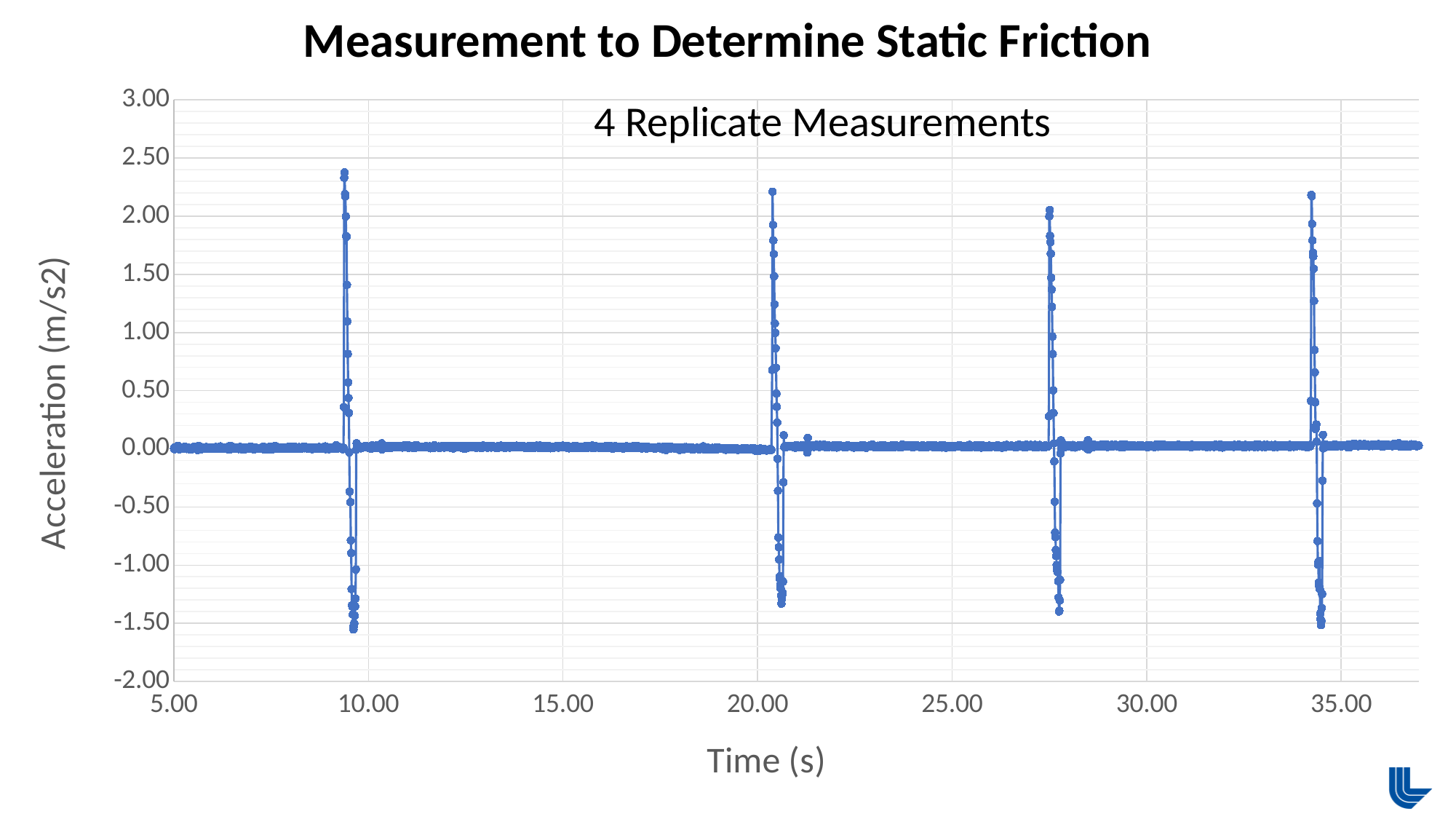
What is the label of the y axis? Acceleration (m/s2) Is the peak acceleration of the first spike (near 9.5 s) greater or less than 2.00? greater What is the title of the chart? Measurement to Determine Static Friction What kind of chart is shown on the slide? scatter chart Is the lowest acceleration of the second spike (near 20.5 s) greater or less than -1.00? less How many replicate measurements (spikes) does the chart show? 4 Which spike reaches the highest peak acceleration: the first (near 9.5 s), second, third or fourth? the first Is the peak acceleration of the third spike (near 27.5 s) greater or less than 2.50? less What is the highest value shown on the y axis? 3.00 Between the spikes, does the acceleration stay roughly constant, rise, or fall over time? roughly constant Which has the higher peak acceleration: the first spike (near 9.5 s) or the third spike (near 27.5 s)? the first spike